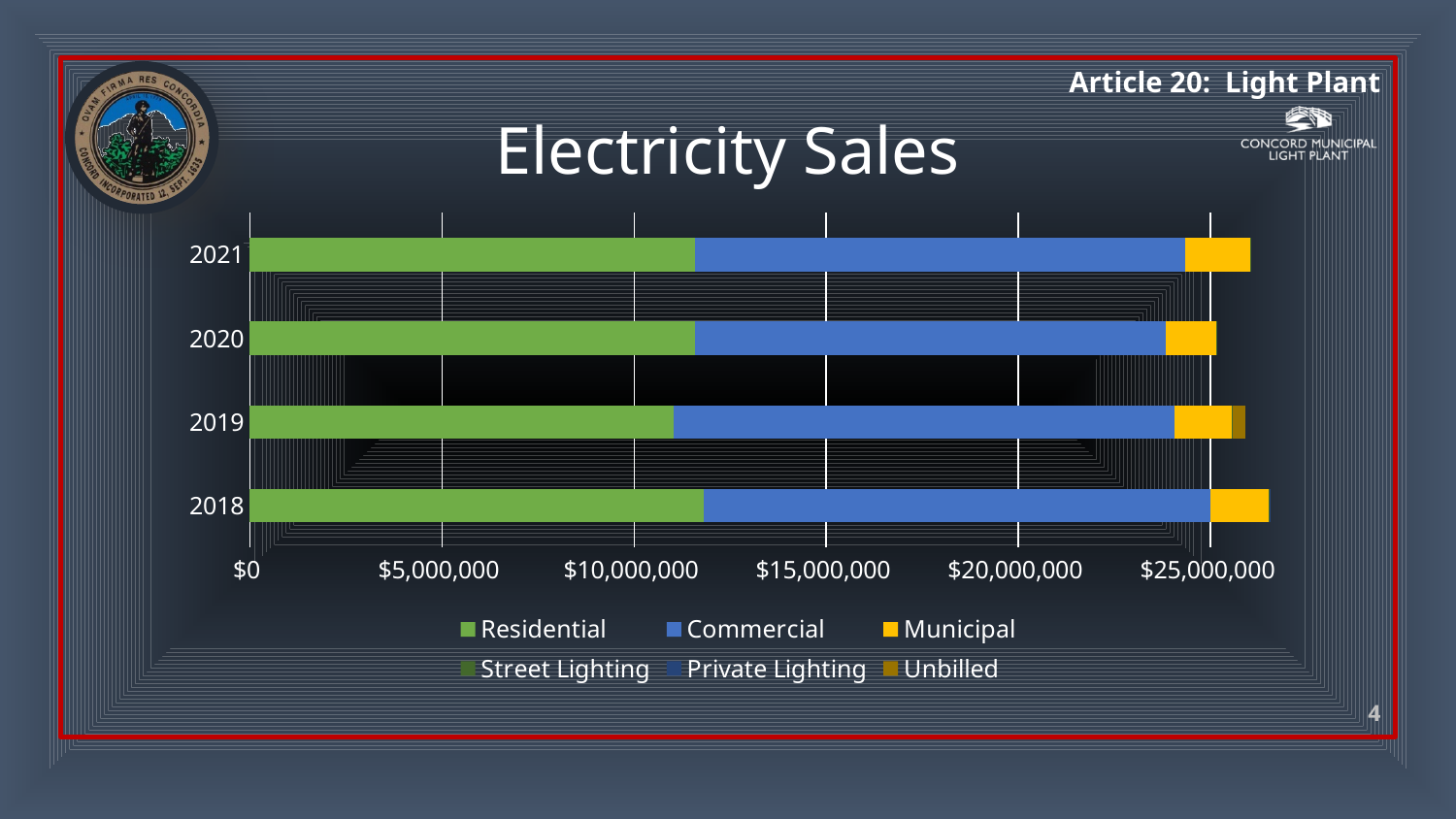
Which year has the longest total bar? 2018 What kind of chart is shown on the slide? Stacked bar chart Which is larger in 2021, the Residential segment or the Commercial segment? Commercial Which series is shown in yellow in the legend? Municipal Which year has the shortest total bar? 2020 Is the Residential value for 2019 greater or less than $15,000,000? less How many years are shown on the chart? 4 Is the total bar for 2021 greater or less than $25,000,000? greater Is the Residential value for 2018 greater or less than $10,000,000? greater What is the title of the chart? Electricity Sales How many series does the legend list? 6